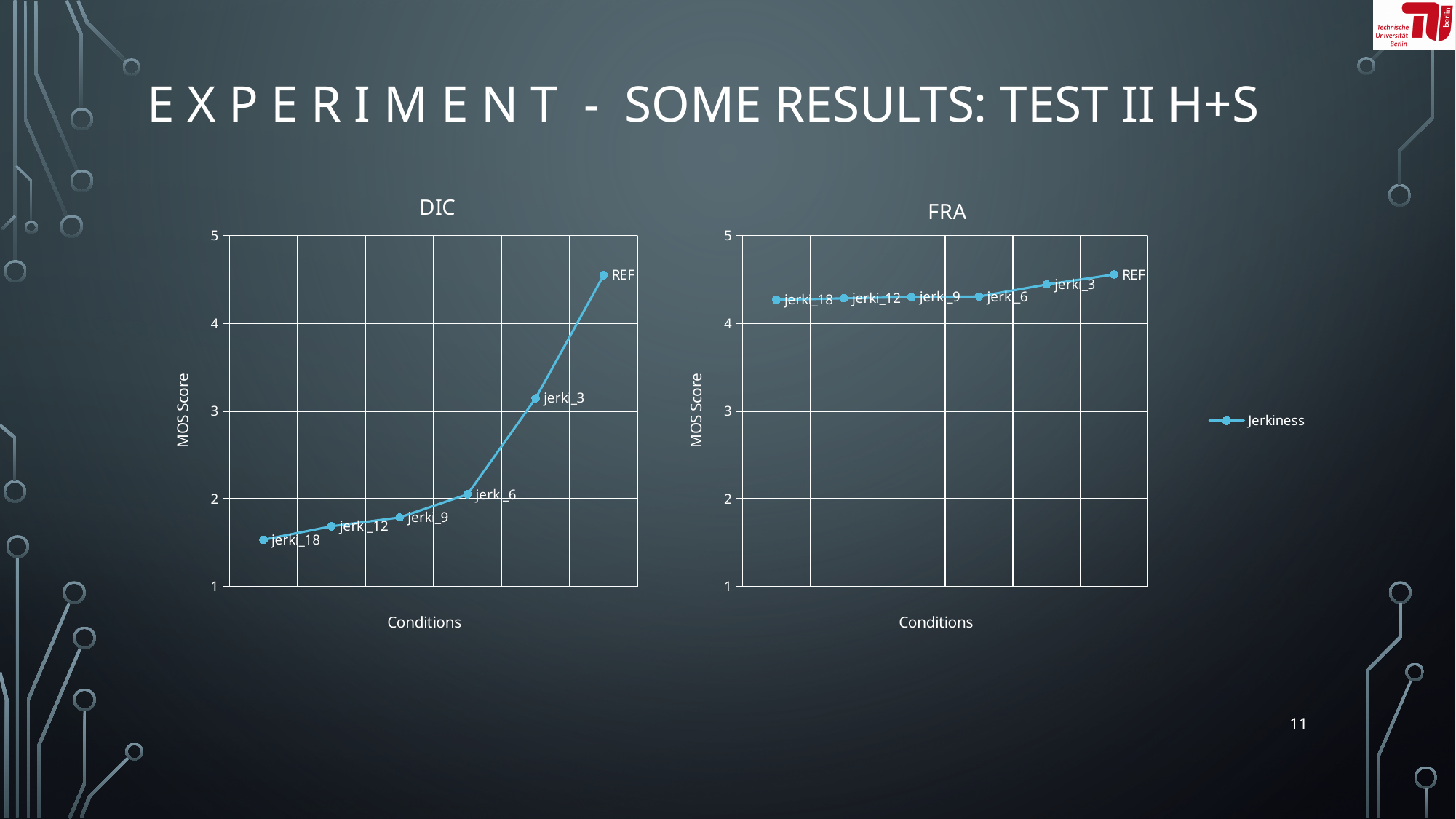
In the DIC chart, which has a higher MOS Score, jerki_3 or jerki_6? jerki_3 How many data points are plotted in the FRA chart? 6 In the DIC chart, which condition has the lowest MOS Score? jerki_18 How many series does the legend list? 1 In the FRA chart, is the MOS Score for jerki_18 greater or less than 4? greater Does the MOS Score in the DIC chart rise or fall from jerki_18 to REF? rise In the FRA chart, which condition has the highest MOS Score? REF In the DIC chart, which condition has the highest MOS Score? REF What is the label of the y axis in the FRA chart? MOS Score In the DIC chart, is the MOS Score for jerki_18 greater or less than 2? less In the DIC chart, is the MOS Score for REF greater or less than 4? greater What kind of chart is the DIC chart? line chart